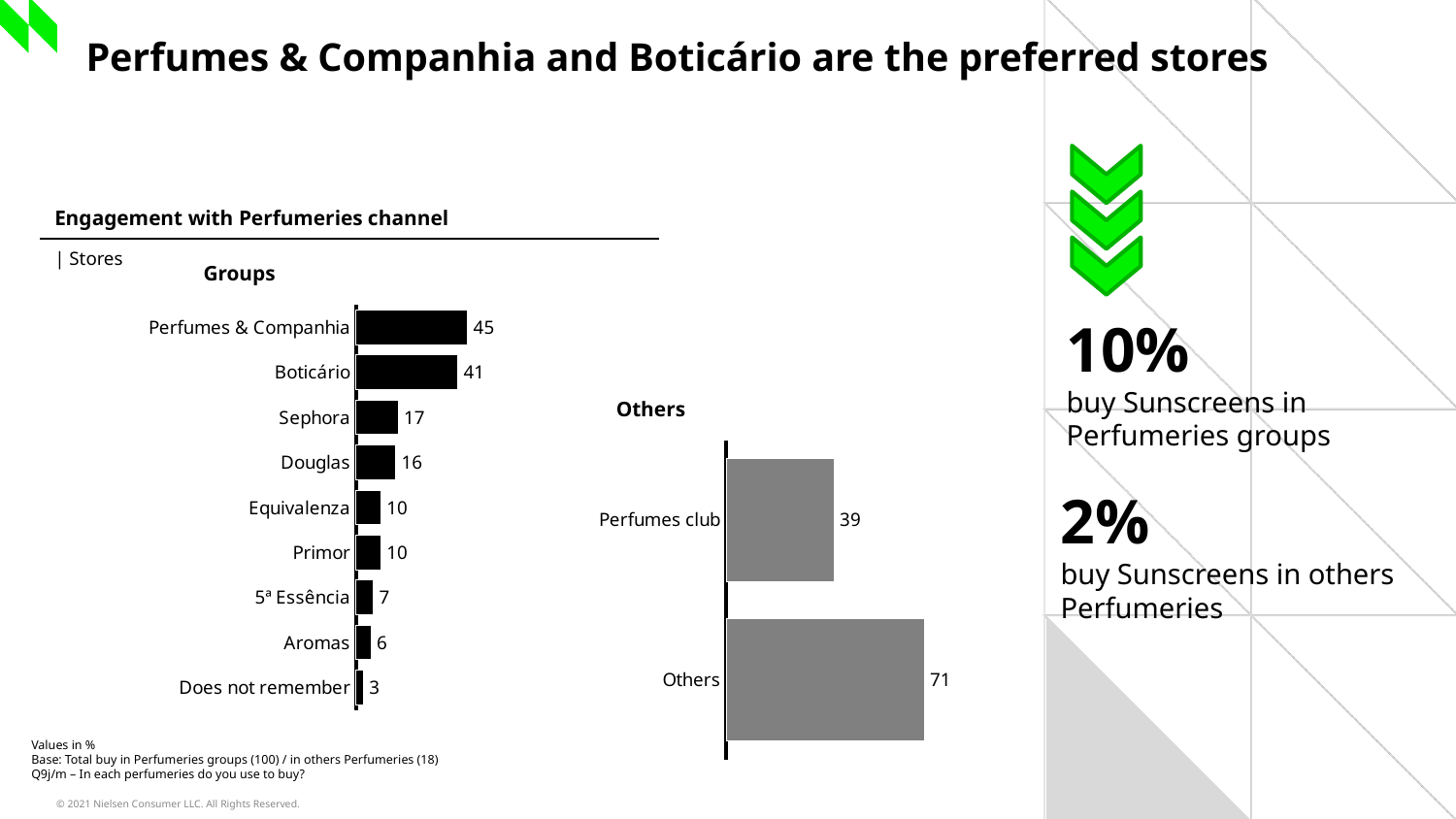
In the Groups chart, which store has the highest value? Perfumes & Companhia In the Groups chart, what is the value for Sephora? 17 In the Groups chart, what is the difference between Perfumes & Companhia and Boticário? 4 In the Others chart, what is the difference between Others and Perfumes club? 32 In the Groups chart, which is larger, Douglas or Equivalenza? Douglas How many categories are shown in the Groups chart? 9 What kind of chart is the Groups chart? Bar chart In the Groups chart, what is the value for Perfumes & Companhia? 45 In the Others chart, what is the value for Others? 71 How many categories are shown in the Others chart? 2 In the Groups chart, which category has the lowest value? Does not remember In the Others chart, what is the value for Perfumes club? 39